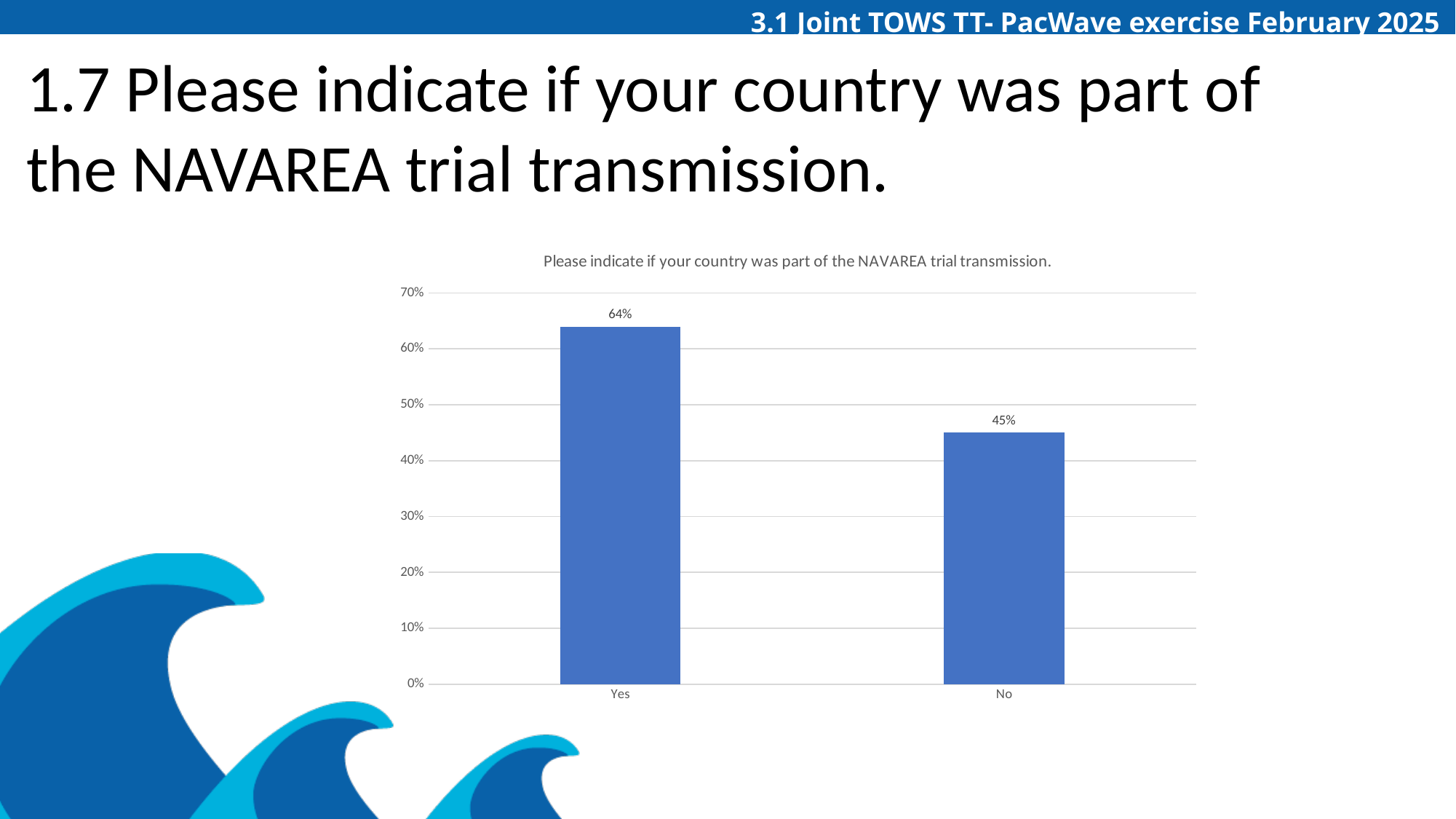
What kind of chart is shown on the slide? bar chart What is the highest value shown on the y axis? 70% What is the value for Yes? 64% What is the difference between the values for Yes and No? 19% Is the value for No greater or less than 50%? less Which category has the highest value? Yes What is the title of the chart? Please indicate if your country was part of the NAVAREA trial transmission. Which category has the lowest value? No What is the value for No? 45% Which is larger, the value for Yes or the value for No? Yes How many categories are shown on the x axis? 2 Is the value for Yes greater or less than 60%? greater